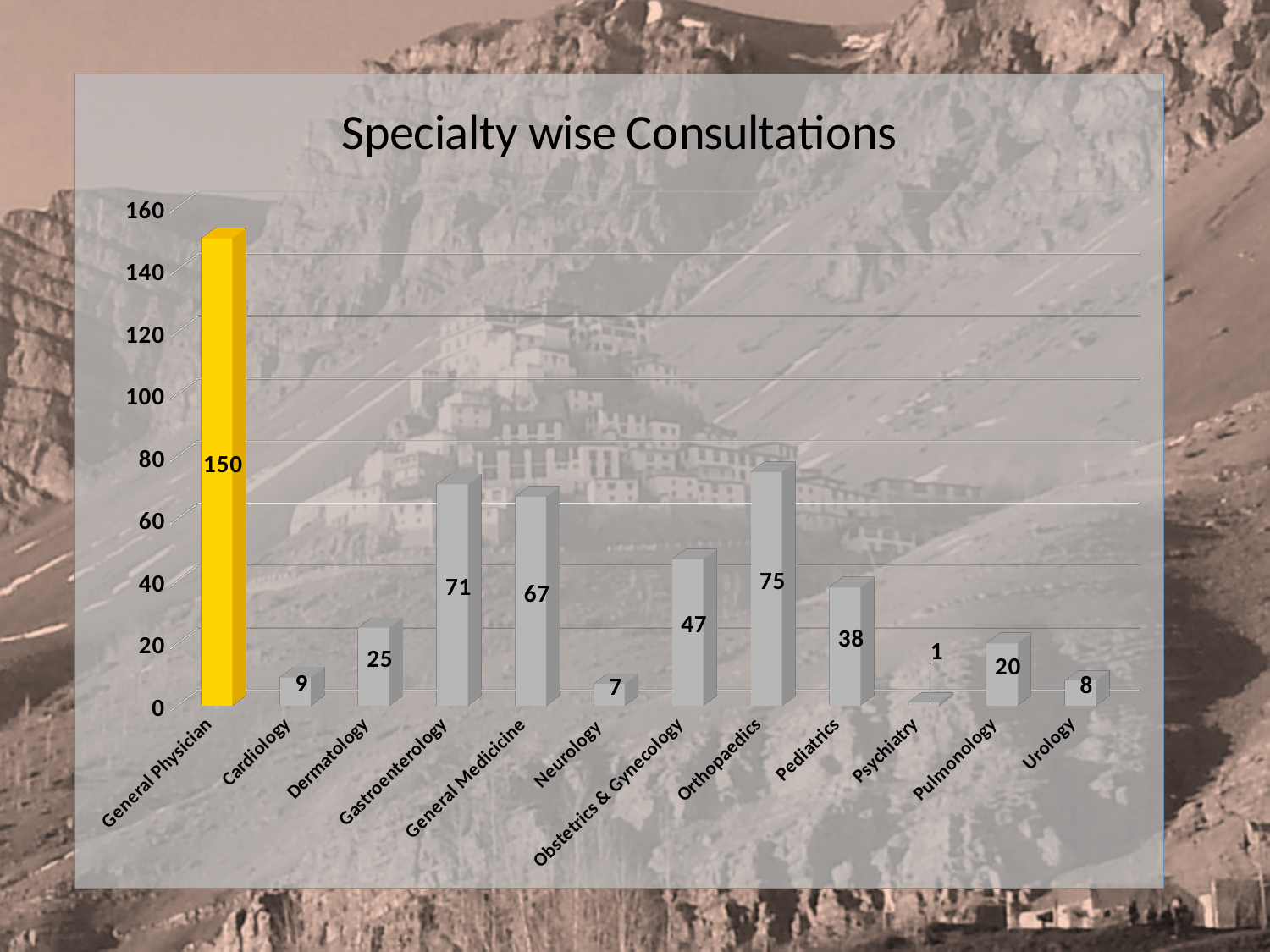
Which bar is coloured yellow while the others are grey? General Physician What is the value for Orthopaedics? 75 What kind of chart is shown on the slide? Bar chart Is the value for Obstetrics & Gynecology greater or less than 40? greater Which is larger, the value for Pediatrics or the value for Dermatology? Pediatrics What is the value for General Physician? 150 Which specialty has the lowest number of consultations? Psychiatry What is the title of the chart? Specialty wise Consultations Which specialty has the highest number of consultations? General Physician What is the value for Psychiatry? 1 How many specialties are shown on the chart? 12 What is the difference between the values for Gastroenterology and General Medicine? 4